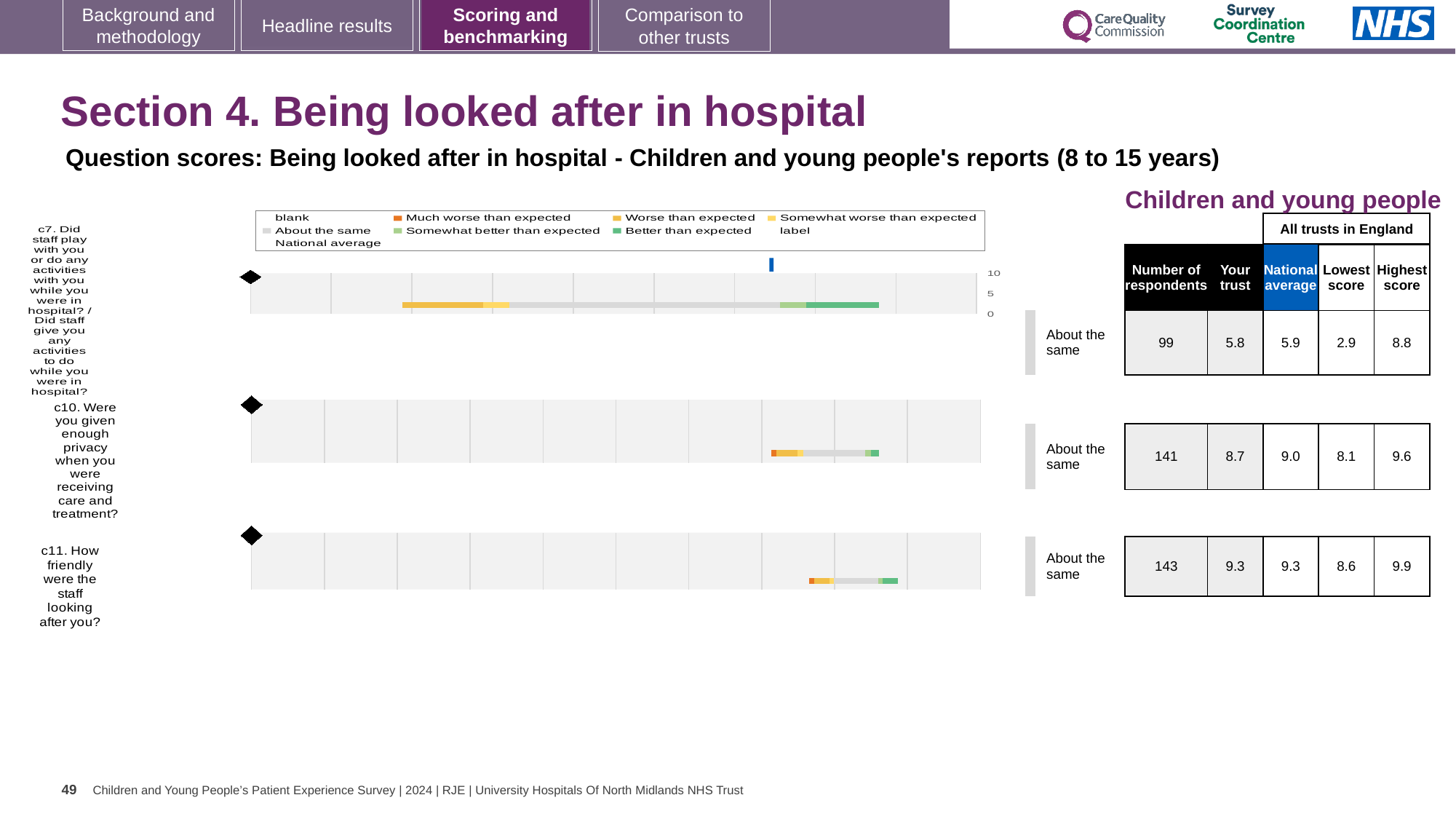
How many survey questions are plotted in the chart? 3 What benchmark category is shown for c11 (How friendly were the staff looking after you?)? About the same What is the highest score among all trusts in England for c10? 9.6 Which question has the highest 'Your trust' score? c11. How friendly were the staff looking after you? What kind of chart is used to show the question scores? bar chart What is the difference between the national average and the 'Your trust' score for c10? 0.3 What is the 'Your trust' score for c10 (Were you given enough privacy when you were receiving care and treatment?)? 8.7 For c7, is the 'Your trust' score higher or lower than the national average? lower How many respondents answered c11 (How friendly were the staff looking after you?)? 143 What is the lowest score among all trusts in England for c7? 2.9 Which question has the lowest number of respondents? c7. Did staff play with you or do any activities with you while you were in hospital? What is the national average score for c7 (Did staff play with you or do any activities with you while you were in hospital?)? 5.9